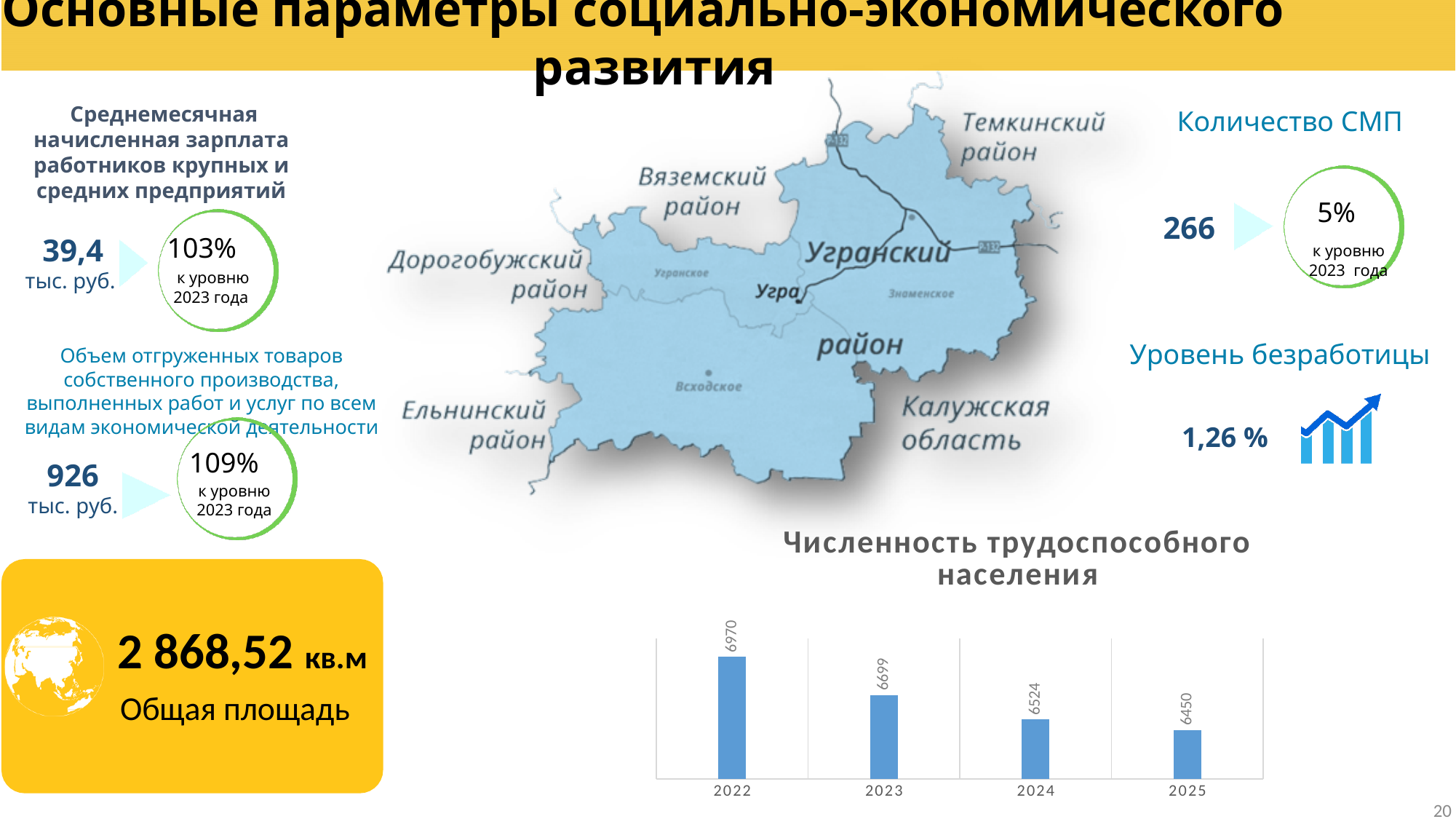
In the 'Численность трудоспособного населения' chart, what is the difference between the values for 2023 and 2024? 175 What is the value for 2024 in the 'Численность трудоспособного населения' chart? 6524 In the 'Численность трудоспособного населения' chart, which is larger: the value for 2023 or the value for 2024? 2023 What is the value for 2025 in the 'Численность трудоспособного населения' chart? 6450 What kind of chart is 'Численность трудоспособного населения'? bar chart In the 'Численность трудоспособного населения' chart, what is the difference between the values for 2022 and 2025? 520 What is the value for 2023 in the 'Численность трудоспособного населения' chart? 6699 What is the value for 2022 in the 'Численность трудоспособного населения' chart? 6970 Do the values in the 'Численность трудоспособного населения' chart rise or fall from 2022 to 2025? fall Which year has the highest value in the 'Численность трудоспособного населения' chart? 2022 How many years are shown in the 'Численность трудоспособного населения' chart? 4 Which year has the lowest value in the 'Численность трудоспособного населения' chart? 2025